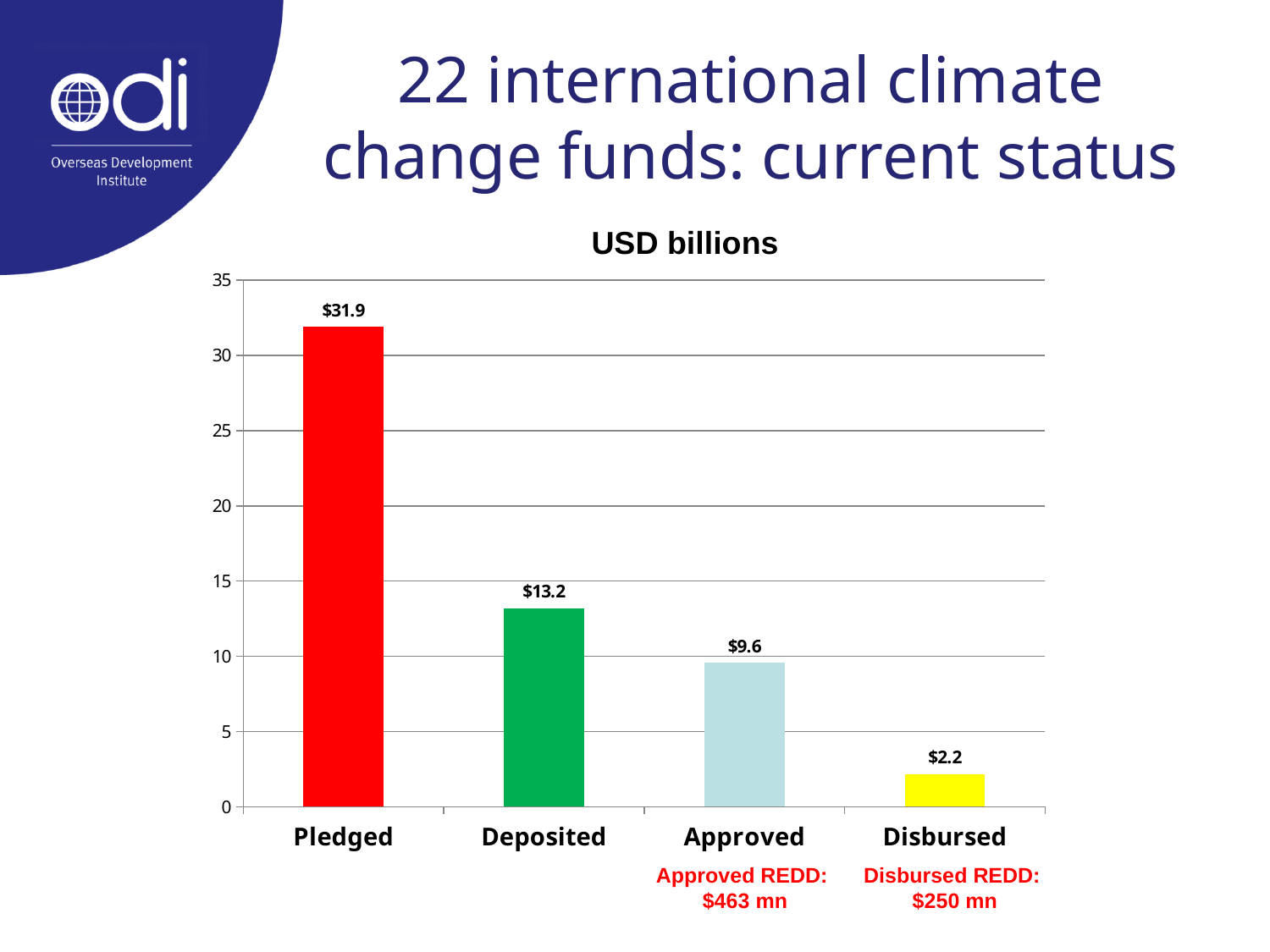
What is the difference between the Approved and Disbursed values? $7.4 How many categories are shown on the x axis? 4 Which category has the lowest value? Disbursed What is the value for Disbursed? $2.2 What kind of chart is shown on the slide? Bar chart What is the value for Deposited? $13.2 What is the value for Pledged? $31.9 What is the value for Approved? $9.6 Which is larger, the value for Deposited or the value for Approved? Deposited Do the values rise or fall from Pledged to Disbursed along the x axis? Fall What is the difference between the Pledged and Deposited values? $18.7 Which category has the highest value? Pledged